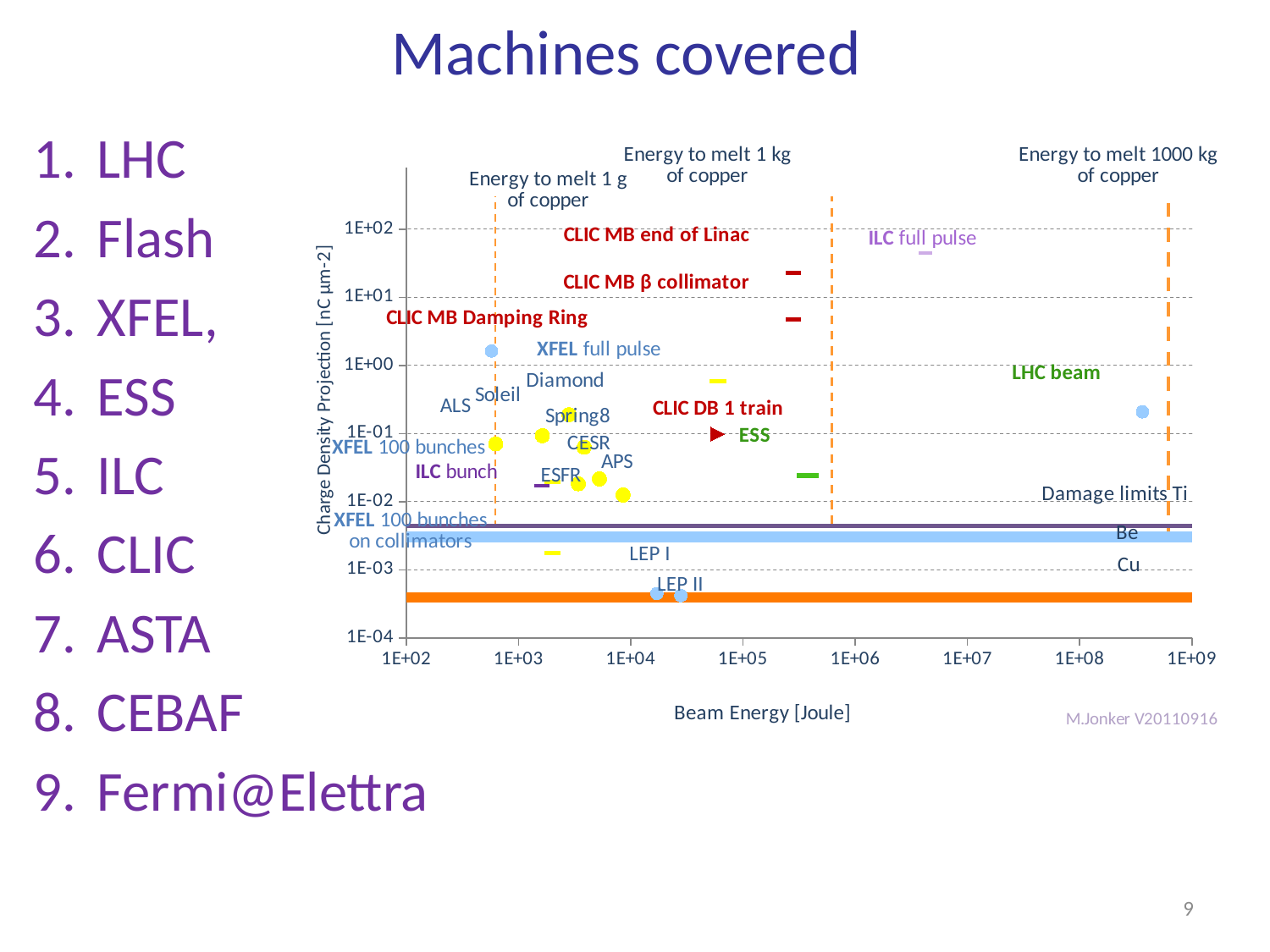
Which has the higher charge density projection, CLIC MB end of Linac or CLIC MB β collimator? CLIC MB end of Linac Is the beam energy for XFEL full pulse greater or less than 1E+03 Joule? less What is the title of the y axis of the chart? Charge Density Projection [nC µm-2] Is the beam energy for LHC beam greater or less than 1E+08 Joule? greater Which has the higher charge density projection, ILC full pulse or LHC beam? ILC full pulse Which has the higher beam energy, LHC beam or XFEL full pulse? LHC beam Is the charge density projection for CLIC MB end of Linac greater or less than 1E+01? greater What is the title of the x axis of the chart? Beam Energy [Joule] What kind of chart is shown on the slide? scatter chart